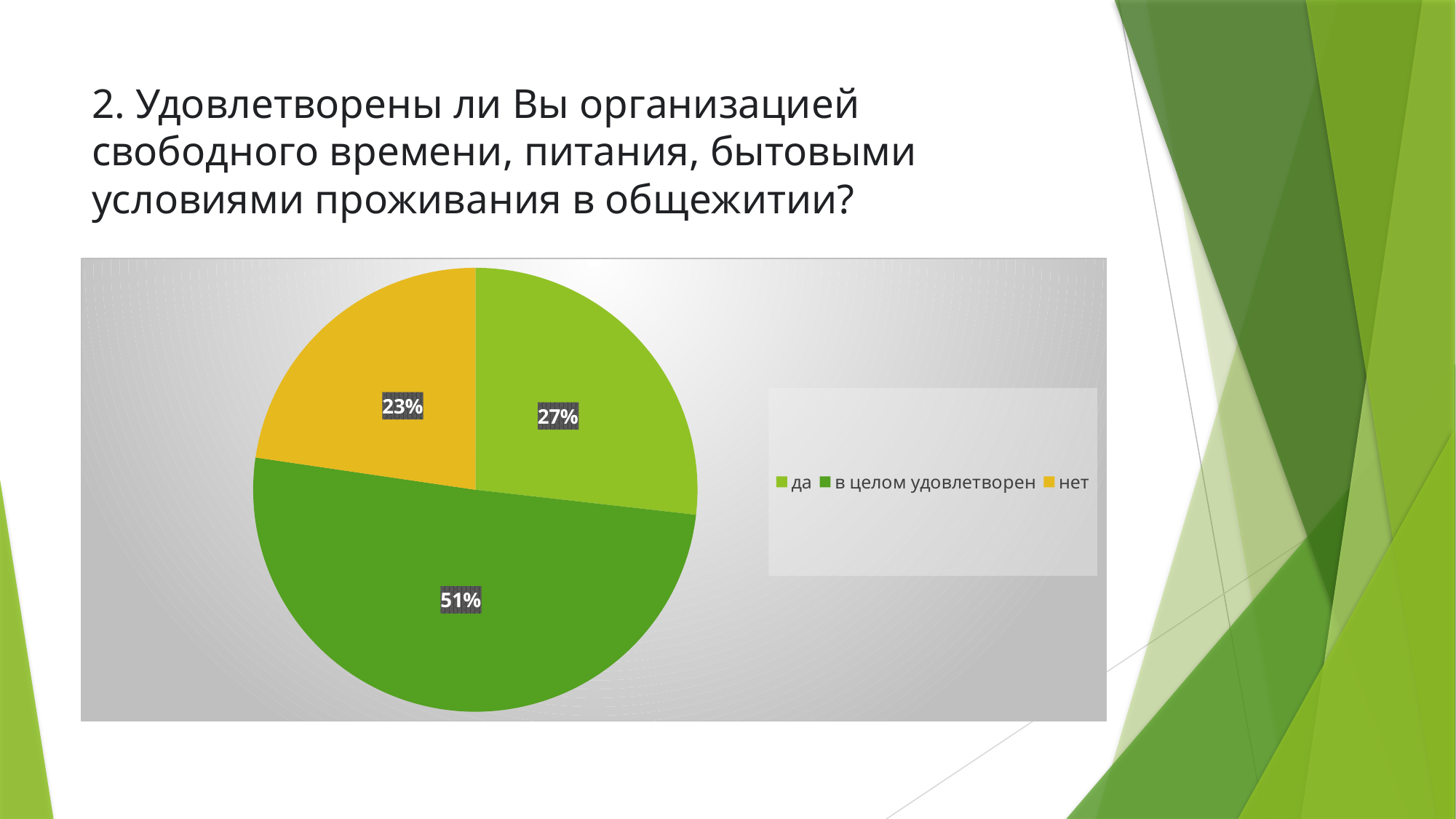
Which answer has the smallest share of the pie? нет What percentage of respondents answered "нет"? 23% What percentage of respondents answered "в целом удовлетворен"? 51% What is the difference in percentage points between "в целом удовлетворен" and "да"? 24 What is the difference in percentage points between "да" and "нет"? 4 How many slices does the pie chart have? 3 What percentage of respondents answered "да"? 27% What kind of chart is shown on the slide? pie chart What colour is the slice for "нет"? yellow Which is larger, the share for "да" or the share for "нет"? да Which answer has the largest share of the pie? в целом удовлетворен How many entries does the legend list? 3